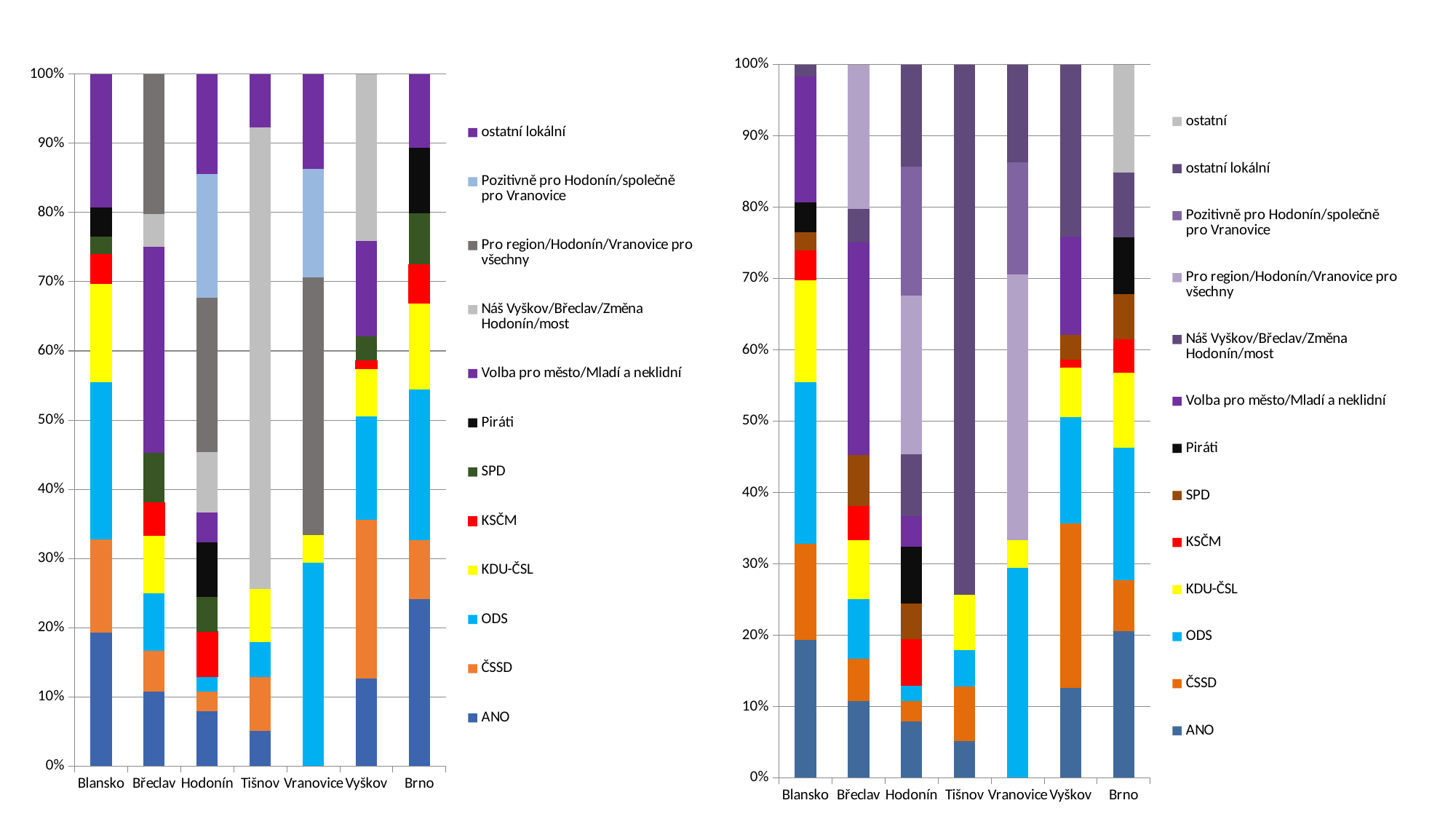
In the left chart, is the ANO value for Tišnov greater or less than 10%? less How many series does the legend of the right chart list? 13 In the left chart, which is larger: the ANO segment for Brno or the ANO segment for Tišnov? Brno What kind of chart is the left chart? stacked bar chart How many categories are shown on the x axis of the left chart? 7 In the left chart, is the ANO value for Brno greater or less than 20%? greater In the right chart, is the ODS value for Vranovice greater or less than 20%? greater Which legend entry appears in the right chart but not in the left chart? ostatní In the right chart, which category has the largest ČSSD segment? Vyškov How many series does the legend of the left chart list? 12 What is the total of the Blansko bar in the right chart? 100% In the left chart, which category has the largest ODS segment? Vranovice